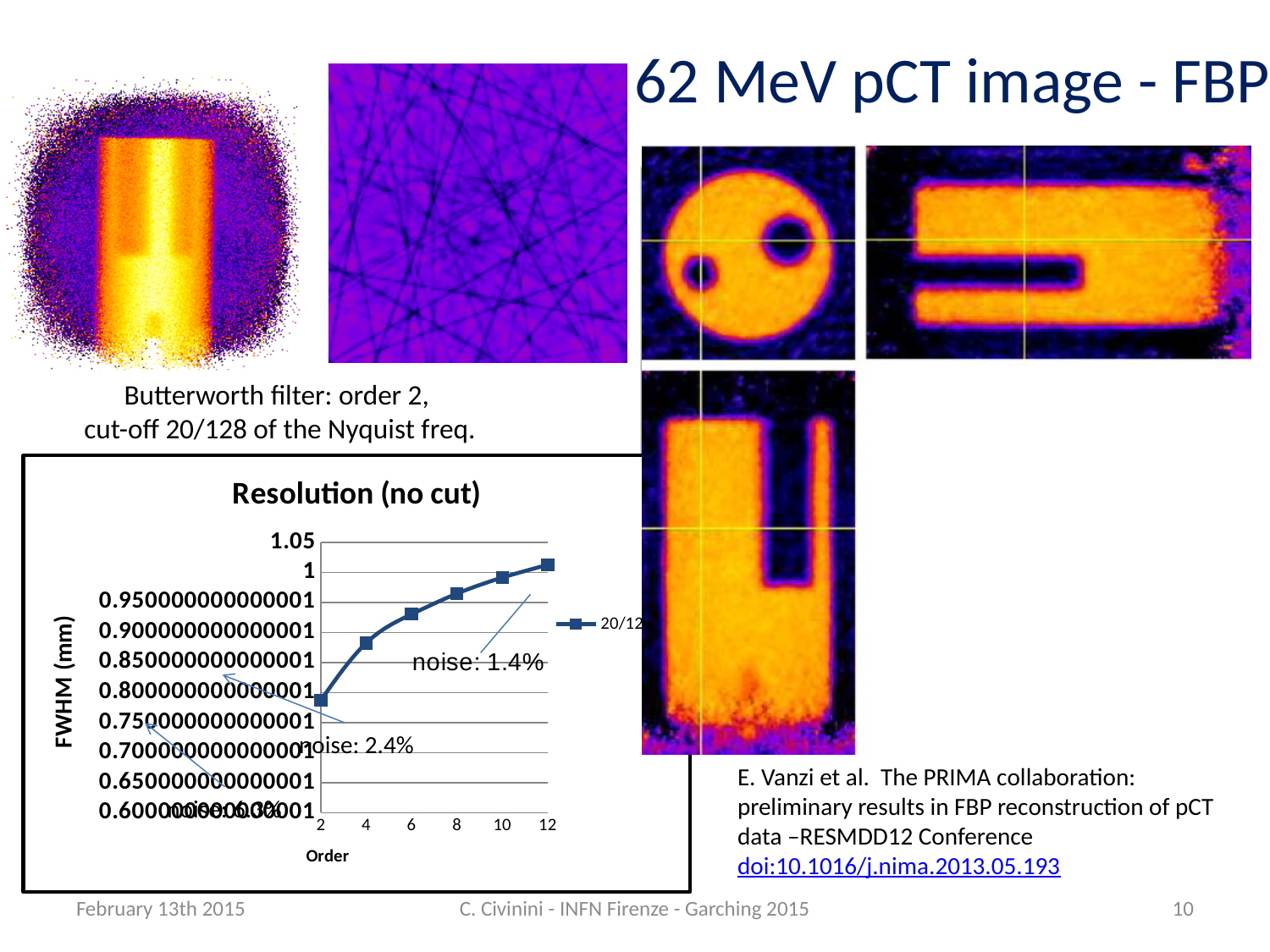
What kind of chart is the "Resolution (no cut)" chart? line chart In the "Resolution (no cut)" chart, is the FWHM at order 12 greater or less than 1? greater In the "Resolution (no cut)" chart, at which order is the FWHM lowest? 2 How many series does the legend of the "Resolution (no cut)" chart list? 1 What is the title of the chart on the slide? Resolution (no cut) In the "Resolution (no cut)" chart, which has the larger FWHM: order 4 or order 10? order 10 In the "Resolution (no cut)" chart, do the FWHM values rise or fall as the order increases? rise What is the label of the y axis of the "Resolution (no cut)" chart? FWHM (mm) In the "Resolution (no cut)" chart, is the FWHM at order 6 greater or less than 0.9? greater In the "Resolution (no cut)" chart, is the FWHM at order 2 greater or less than 0.8? less How many data points are plotted in the "Resolution (no cut)" chart? 6 In the "Resolution (no cut)" chart, at which order is the FWHM highest? 12